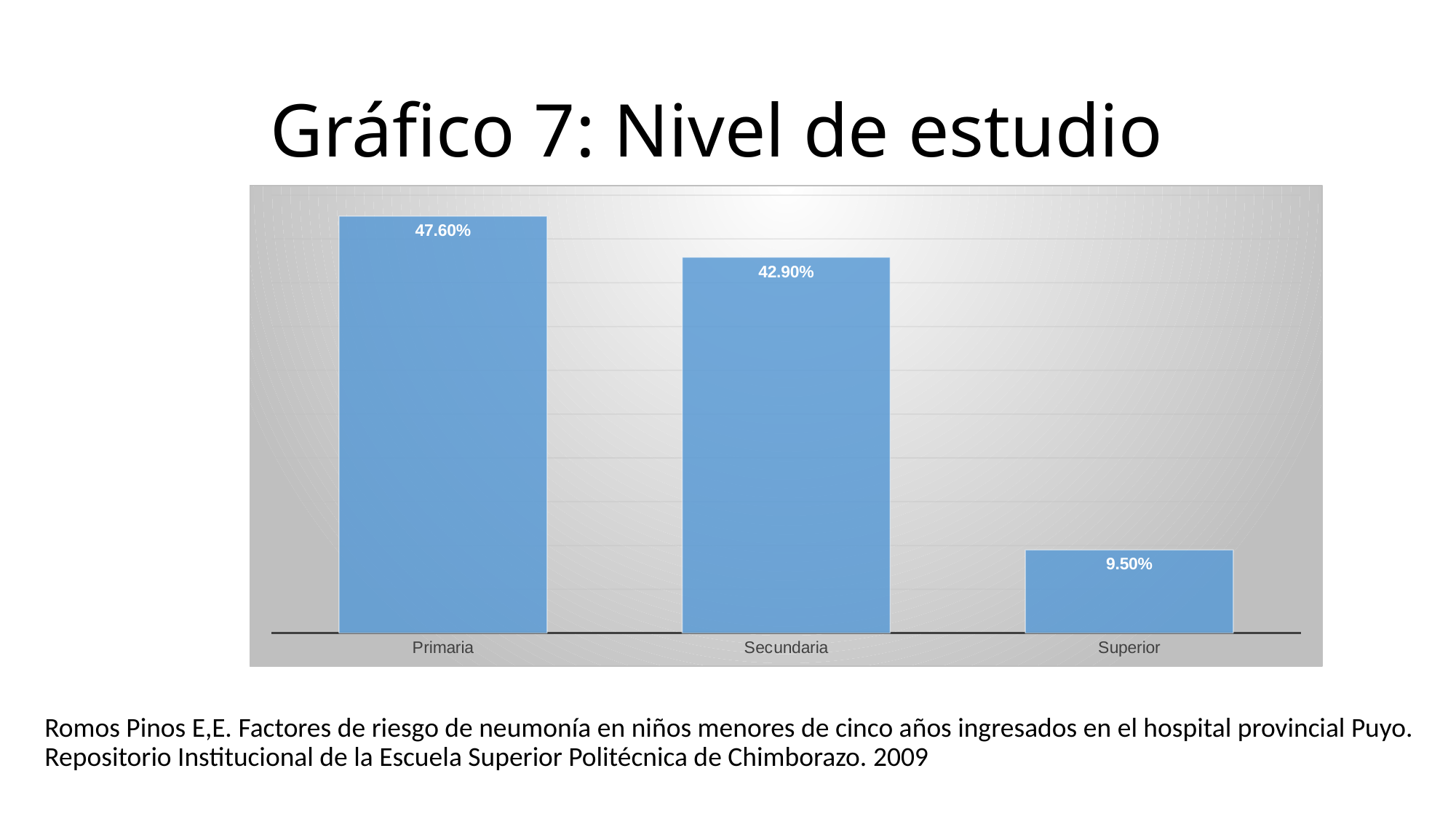
What kind of chart is shown on the slide? Bar chart What is the value for Secundaria? 42.90% Which is larger, the value for Secundaria or the value for Superior? Secundaria What is the value for Primaria? 47.60% What is the value for Superior? 9.50% Which category has the highest value? Primaria How many categories are shown in the chart? 3 Which category has the lowest value? Superior What is the difference between the values for Secundaria and Superior? 33.40% Do the values rise or fall from Primaria to Superior along the x axis? Fall What is the difference between the values for Primaria and Secundaria? 4.70% What is the title of the slide containing the chart? Gráfico 7: Nivel de estudio